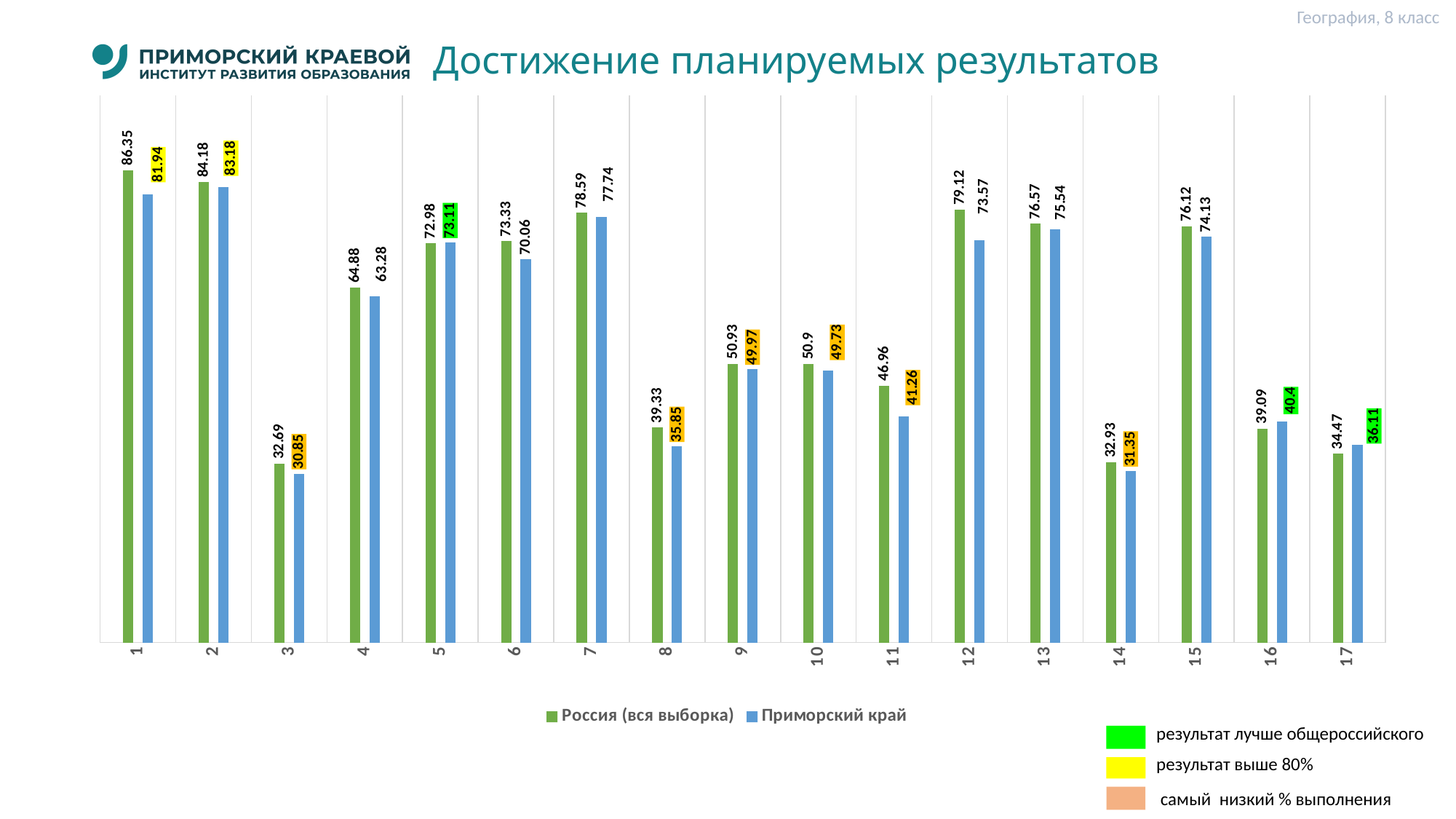
What type of chart is shown on the slide? Bar chart For task 17, which series has the larger value: Россия (вся выборка) or Приморский край? Приморский край Which task has the lowest value for Россия (вся выборка)? 3 For task 6, which series has the larger value: Россия (вся выборка) or Приморский край? Россия (вся выборка) What is the value for Россия (вся выборка) for task 1? 86.35 What is the difference between Россия (вся выборка) and Приморский край for task 12? 5.55 What is the value for Приморский край for task 16? 40.4 What is the difference between Россия (вся выборка) and Приморский край for task 11? 5.7 What is the value for Приморский край for task 12? 73.57 How many tasks (categories) are shown on the x axis? 17 How many series does the legend list? 2 Which task has the highest value for Приморский край? 2